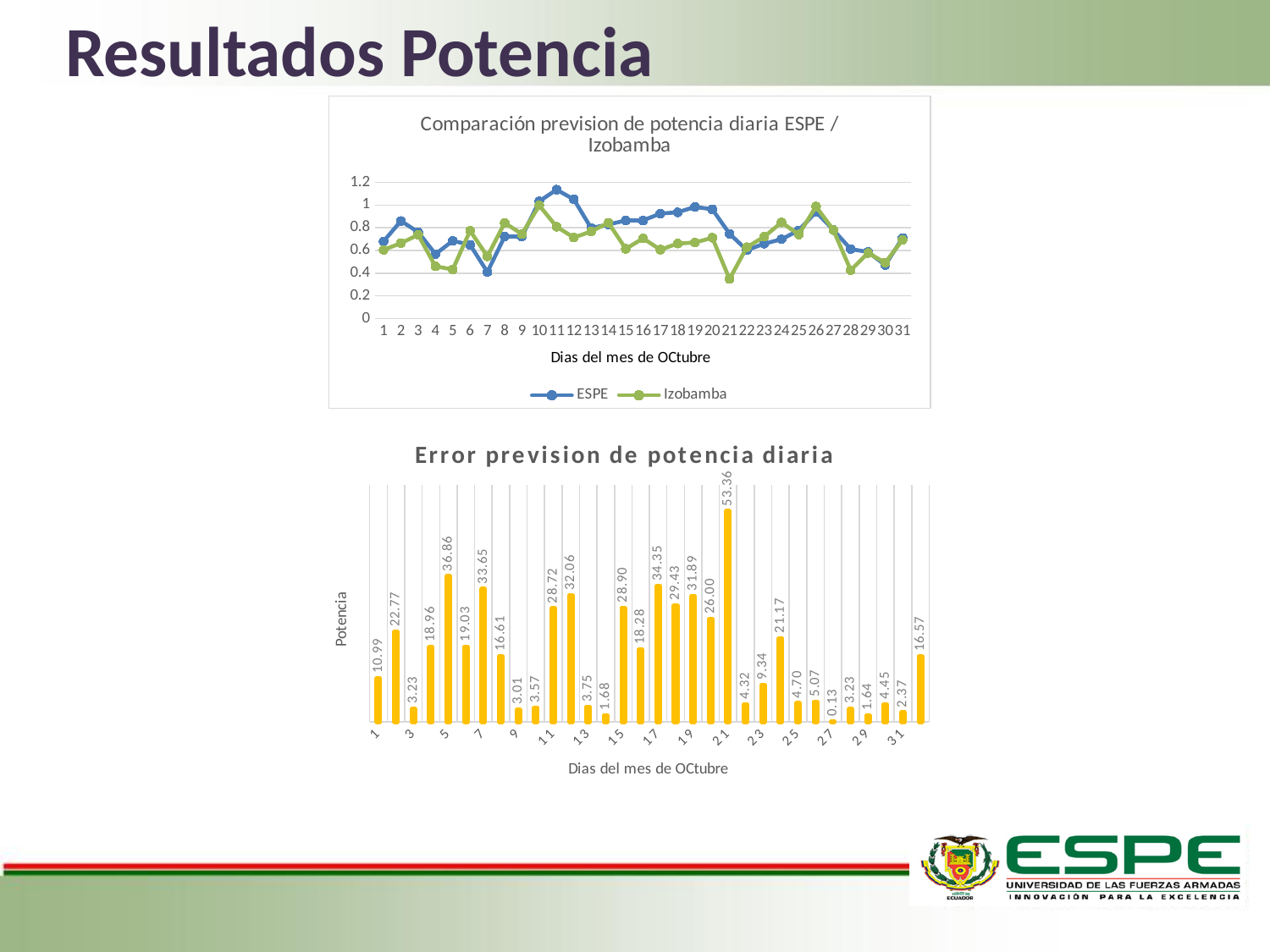
In the bottom chart 'Error prevision de potencia diaria', what is the difference between the values for day 5 and day 7? 3.21 In the bottom chart 'Error prevision de potencia diaria', which day has the larger value, day 11 or day 12? 12 In the bottom chart 'Error prevision de potencia diaria', which day has the highest error value? 21 In the bottom chart 'Error prevision de potencia diaria', how many bars are plotted? 32 In the top chart 'Comparación prevision de potencia diaria ESPE / Izobamba', how many series does the legend list? 2 What kind of chart is the bottom chart titled 'Error prevision de potencia diaria'? bar chart In the bottom chart 'Error prevision de potencia diaria', what is the value for day 5? 36.86 In the top chart 'Comparación prevision de potencia diaria ESPE / Izobamba', is the ESPE value for day 11 greater or less than 1? greater What kind of chart is the top chart titled 'Comparación prevision de potencia diaria ESPE / Izobamba'? line chart In the top chart 'Comparación prevision de potencia diaria ESPE / Izobamba', is the ESPE value for day 7 greater or less than 0.6? less In the bottom chart 'Error prevision de potencia diaria', which day has the lowest error value? 27 In the bottom chart 'Error prevision de potencia diaria', what is the value for day 21? 53.36